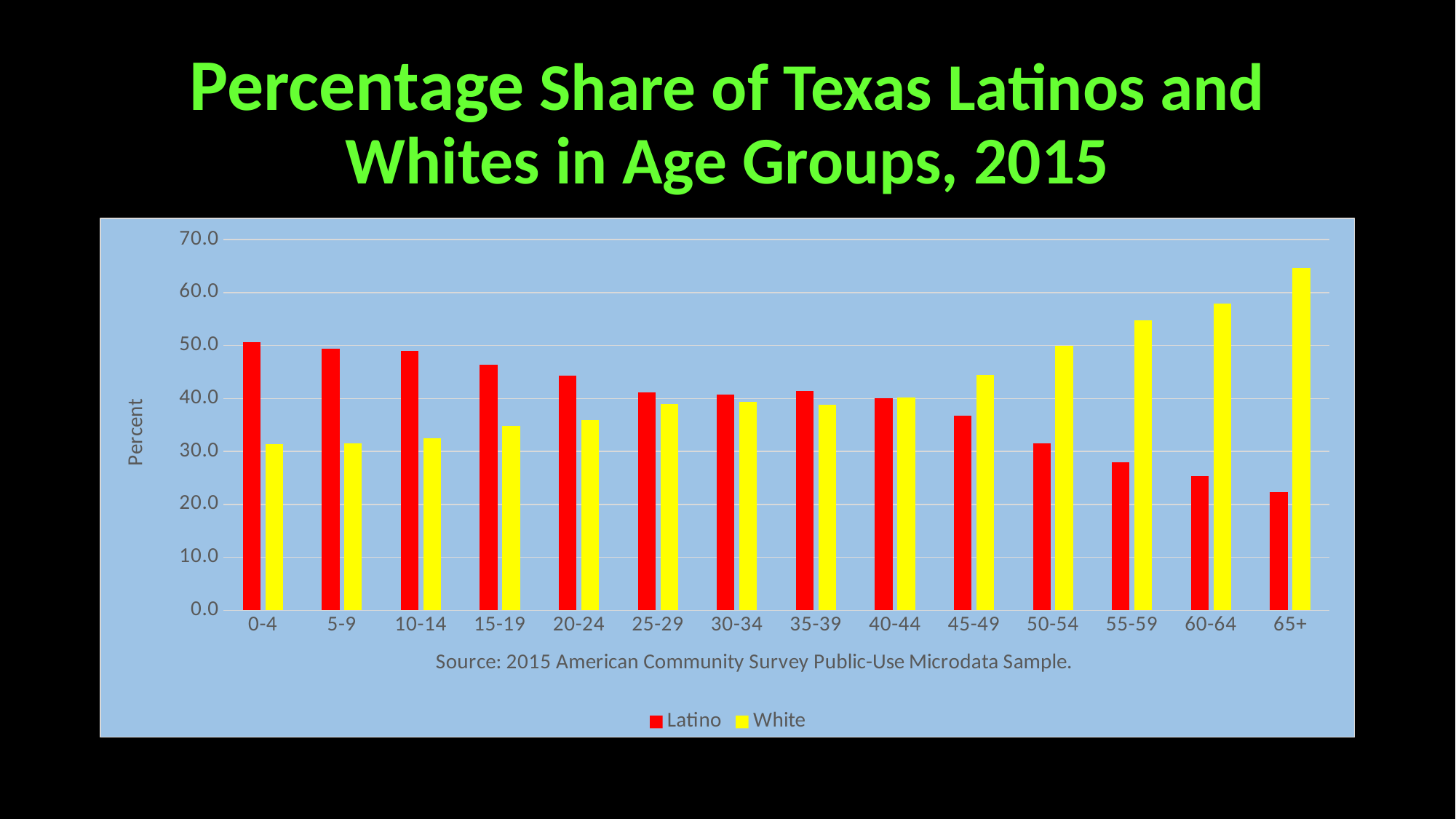
For the 0-4 age group, which is larger, the Latino or the White value? Latino Which age group has the highest White value? 65+ Do the Latino values generally rise or fall as age increases along the x axis? Fall Is the Latino value for 65+ greater or less than 30.0? less How many age groups are shown on the x axis? 14 Is the White value for 65+ greater or less than 60.0? greater Is the Latino value for 45-49 greater or less than 40.0? less Which age group has the lowest Latino value? 65+ What is the label on the vertical axis? Percent What kind of chart is shown on the slide? Bar chart How many series does the legend list? 2